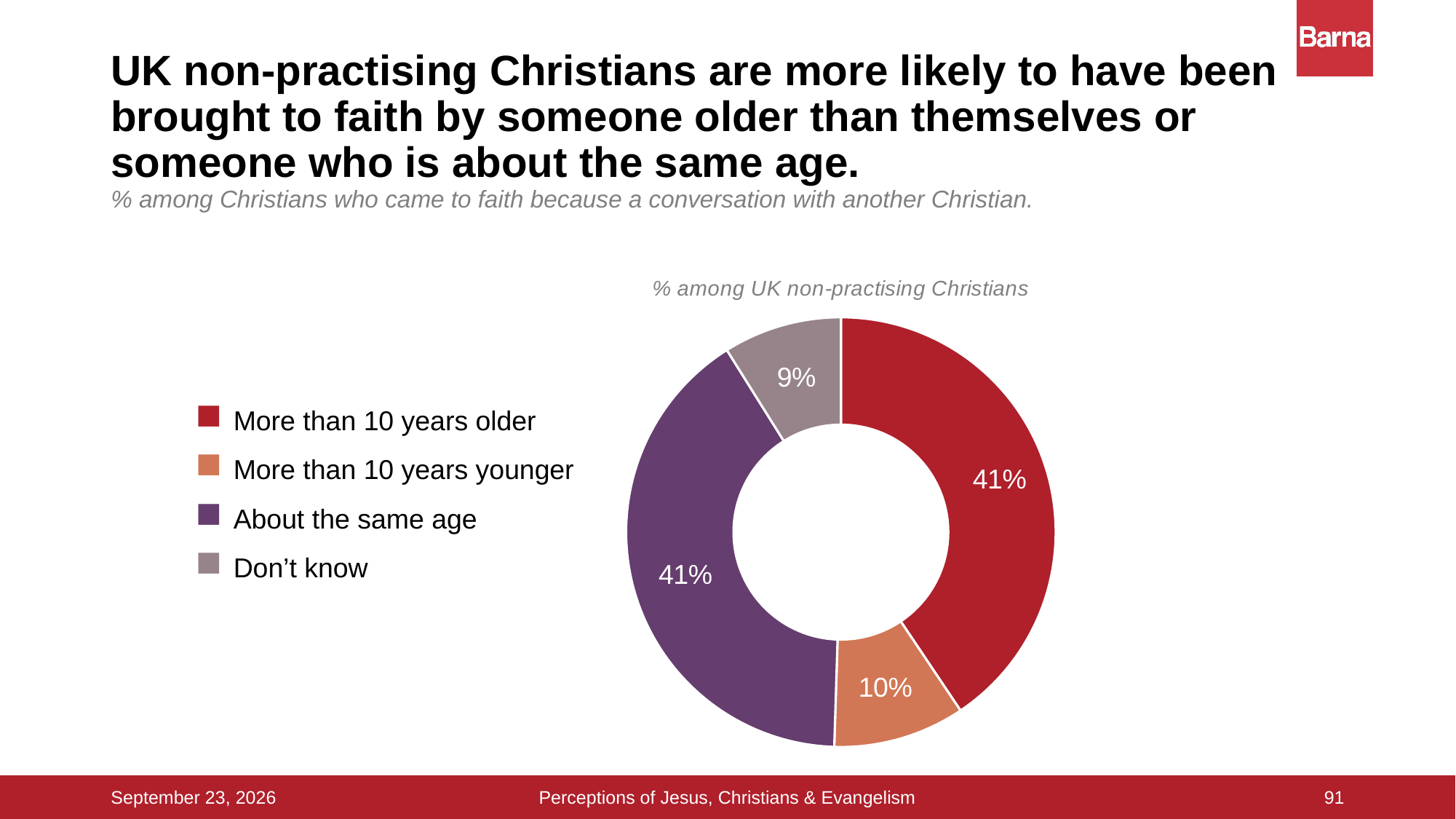
Which is larger: the share for 'About the same age' or the share for 'Don't know'? About the same age What percentage of UK non-practising Christians were brought to faith by someone more than 10 years older? 41% What percentage of UK non-practising Christians answered 'Don't know'? 9% What colour represents 'About the same age' in the chart? purple What is the combined share of 'More than 10 years older' and 'About the same age'? 82% What percentage of UK non-practising Christians were brought to faith by someone more than 10 years younger? 10% How many categories are shown in the chart? 4 What is the difference between the share for 'More than 10 years younger' and the share for 'Don't know'? 1% What kind of chart is shown on the slide? doughnut chart Which category has the smallest share of the chart? Don't know What percentage of UK non-practising Christians were brought to faith by someone about the same age? 41% What is the difference between the share for 'More than 10 years older' and the share for 'More than 10 years younger'? 31%